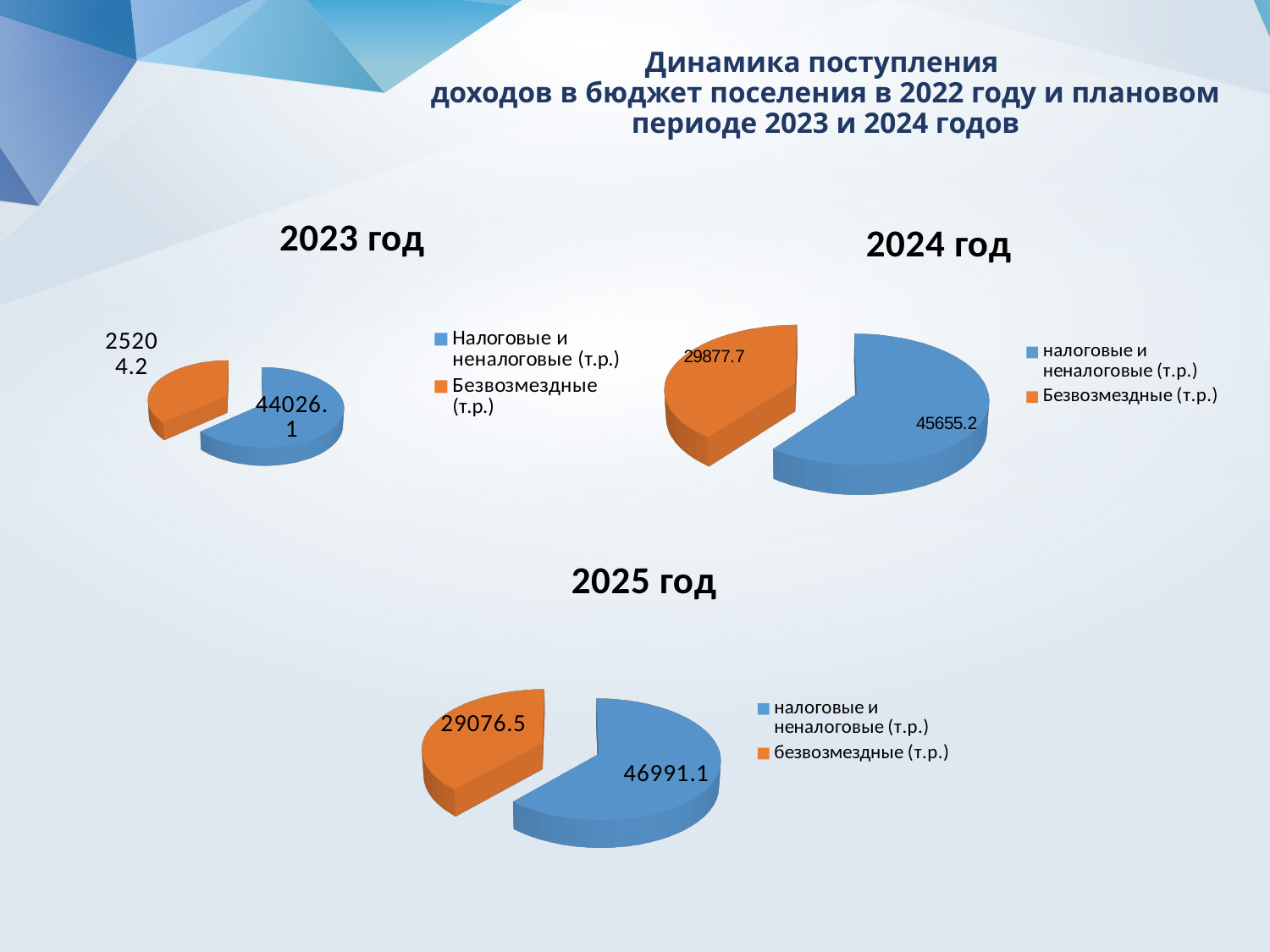
In the "2023 год" chart, what is the difference between Налоговые и неналоговые (т.р.) and Безвозмездные (т.р.)? 18821.9 In the "2023 год" chart, what is the value for Безвозмездные (т.р.)? 25204.2 In the "2023 год" chart, what is the value for Налоговые и неналоговые (т.р.)? 44026.1 What type of chart is the "2024 год" chart? Pie chart In the "2024 год" chart, which category has the smallest slice? Безвозмездные (т.р.) In the "2024 год" chart, what is the value for налоговые и неналоговые (т.р.)? 45655.2 In the "2024 год" chart, what is the total of the two slices? 75532.9 In the "2025 год" chart, what is the difference between налоговые и неналоговые (т.р.) and безвозмездные (т.р.)? 17914.6 In the "2024 год" chart, what is the value for Безвозмездные (т.р.)? 29877.7 In the "2025 год" chart, which category has the largest slice? налоговые и неналоговые (т.р.) In the "2025 год" chart, what is the value for безвозмездные (т.р.)? 29076.5 How many categories does the legend of the "2025 год" chart list? 2